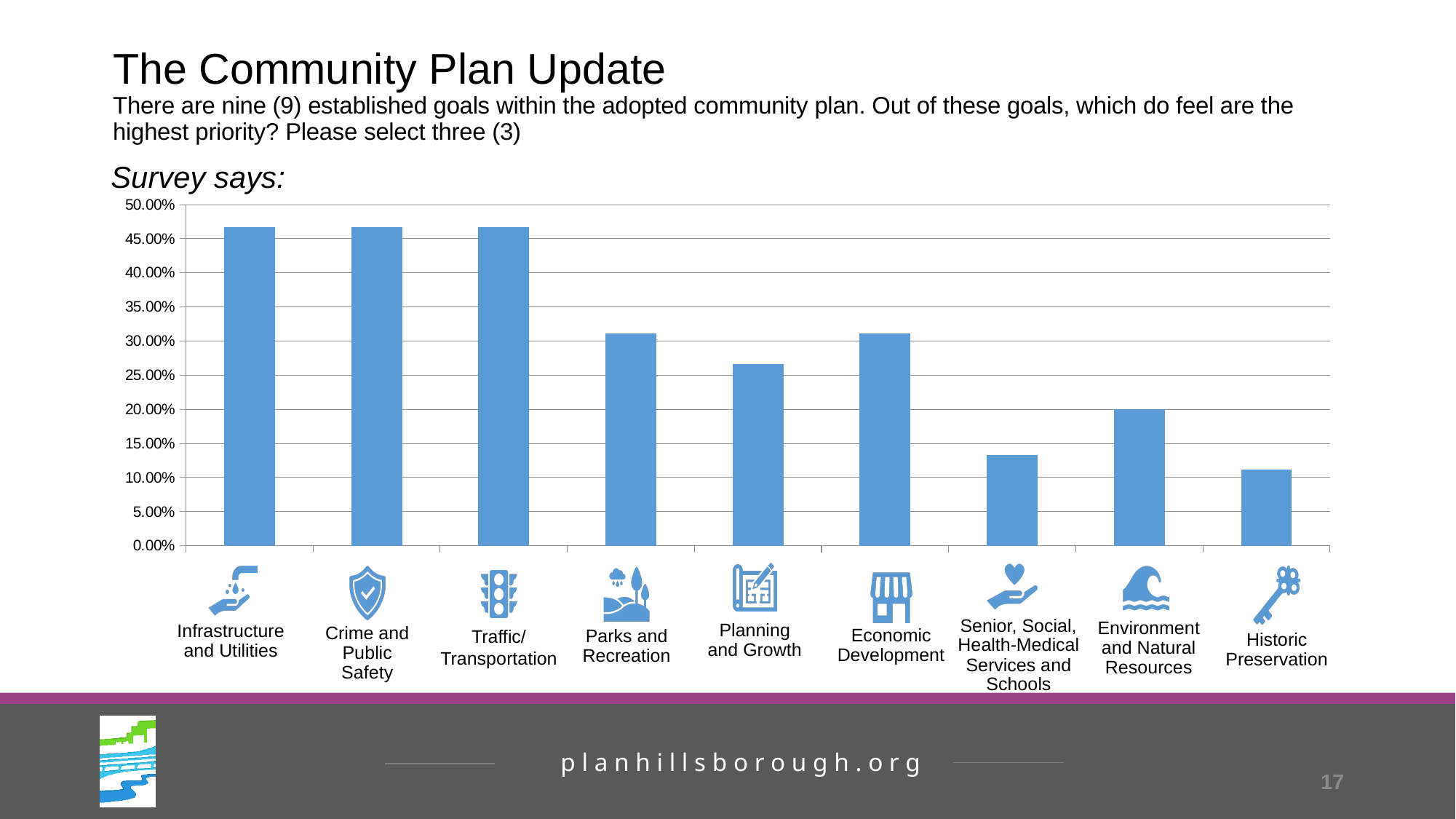
Is the value for Senior, Social, Health-Medical Services and Schools greater or less than 15.00%? less What kind of chart is shown on the slide? bar chart Is the value for Parks and Recreation greater or less than 35.00%? less Which has the larger value, Planning and Growth or Economic Development? Economic Development Is the value for Infrastructure and Utilities greater or less than 45.00%? greater What is the value for Environment and Natural Resources? 20.00% How many goal categories are plotted on the chart? 9 What is the maximum value shown on the vertical axis of the chart? 50.00% Which has the larger value, Environment and Natural Resources or Senior, Social, Health-Medical Services and Schools? Environment and Natural Resources Which category has the lowest value on the chart? Historic Preservation